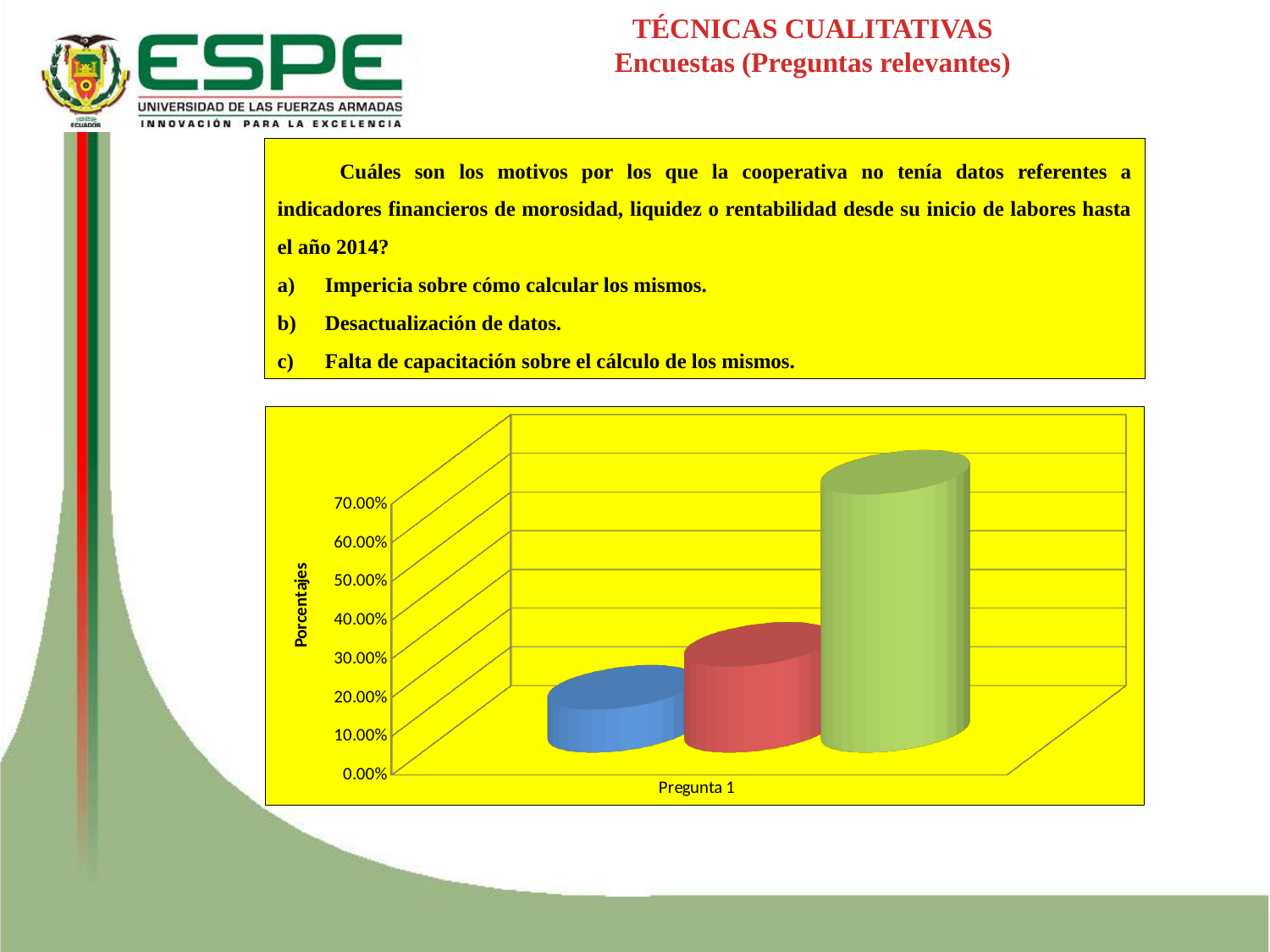
How many categories are shown on the x axis of the chart? 1 Is the red bar taller or shorter than the green bar? shorter What is the label of the category on the x axis of the chart? Pregunta 1 Is the value of the green bar greater or less than 50.00%? greater Is the value of the blue bar greater or less than 40.00%? less What kind of chart is shown on the slide? bar chart Is the value of the red bar greater or less than 10.00%? greater Which bar is the shortest in the chart: the blue, the red or the green one? blue Which bar is the tallest in the chart: the blue, the red or the green one? green Is the green bar taller or shorter than the blue bar? taller What is the title of the vertical axis of the chart? Porcentajes